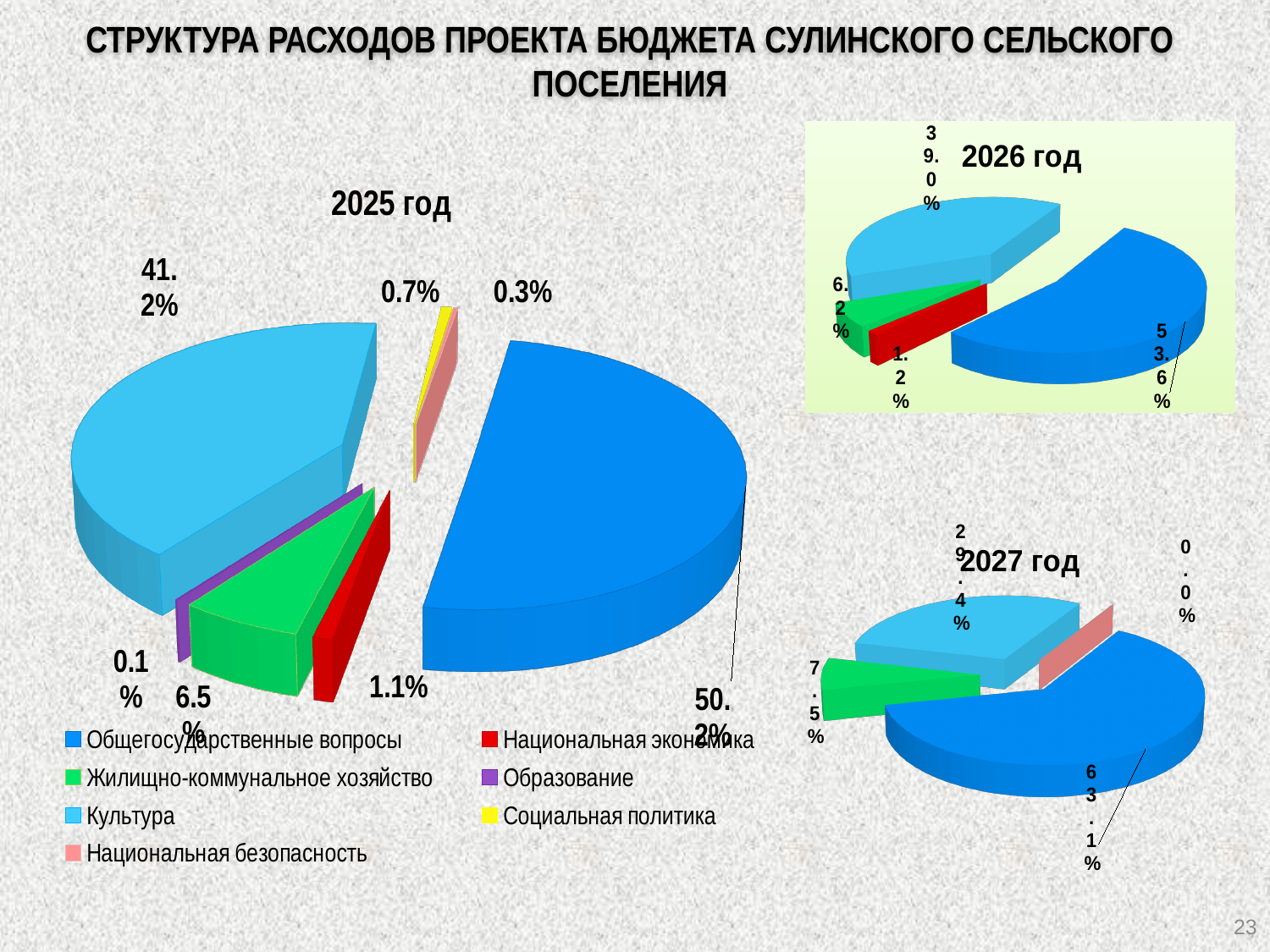
In the 2026 год chart, what share is shown for Общегосударственные вопросы? 53.6% In the 2025 год chart, what share is shown for Жилищно-коммунальное хозяйство? 6.5% In the 2025 год chart, which category has the largest slice? Общегосударственные вопросы How many categories does the legend list? 7 What kind of chart is used for the 2025 год data? Pie chart In the 2027 год chart, what share is shown for Общегосударственные вопросы? 63.1% In the 2025 год chart, which category has the smallest slice? Образование In the 2025 год chart, what is the difference between the shares of Общегосударственные вопросы and Культура? 9.0% In the 2025 год chart, what share is shown for Общегосударственные вопросы? 50.2% In the 2026 год chart, what share is shown for Культура? 39.0% In the 2025 год chart, what share is shown for Культура? 41.2% In the 2027 год chart, which is larger: the share for Культура or the share for Жилищно-коммунальное хозяйство? Культура